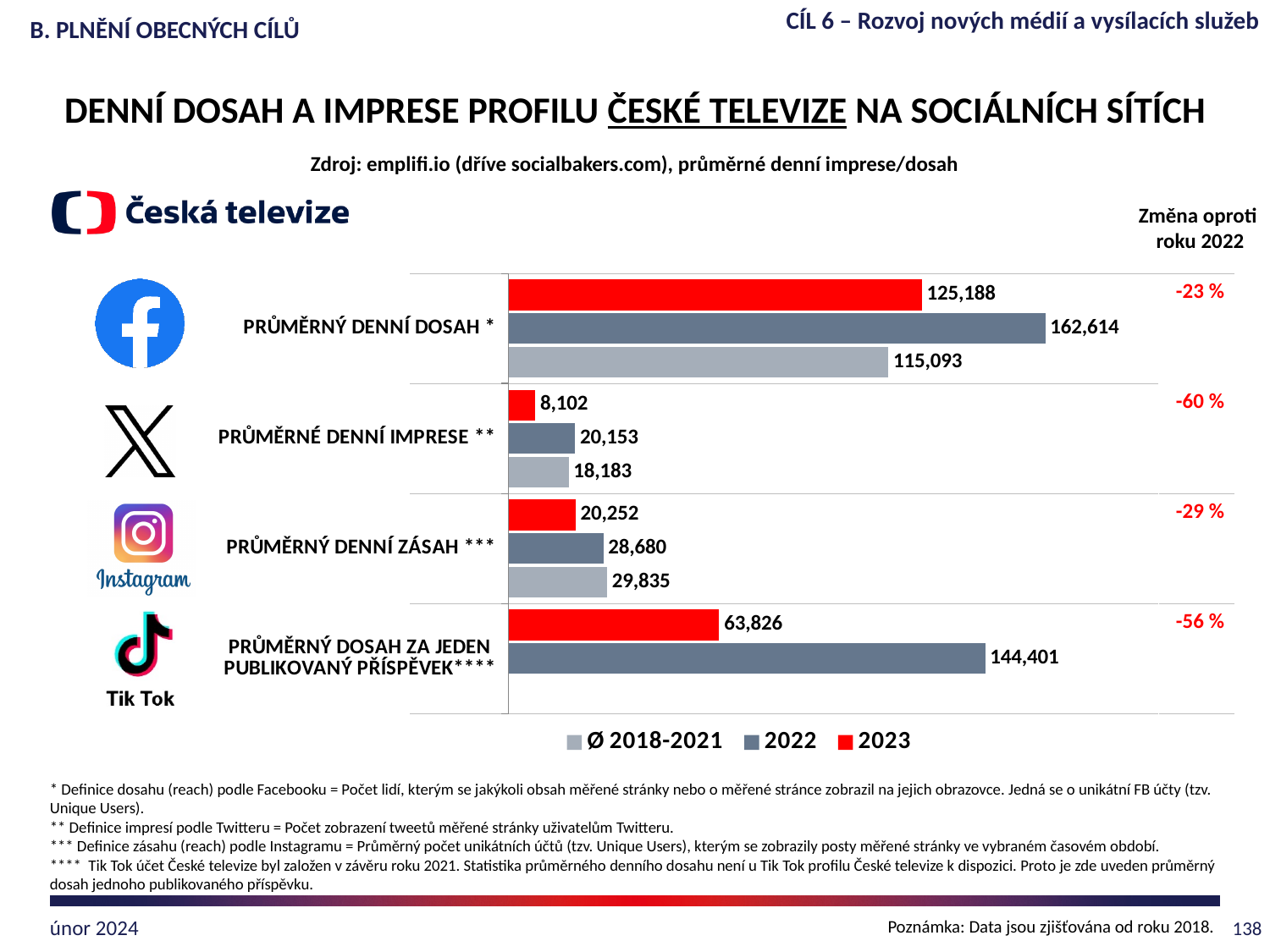
Which category has the highest 2023 value? PRŮMĚRNÝ DENNÍ DOSAH What is the Ø 2018-2021 value for PRŮMĚRNÝ DENNÍ ZÁSAH (Instagram)? 29,835 What is the change versus 2022 shown for PRŮMĚRNÉ DENNÍ IMPRESE (X)? -60 % What is the 2022 value for PRŮMĚRNÝ DOSAH ZA JEDEN PUBLIKOVANÝ PŘÍSPĚVEK (Tik Tok)? 144,401 What kind of chart is shown on the slide? Bar chart How many series does the legend list? 3 What is the 2023 value for PRŮMĚRNÝ DENNÍ DOSAH (Facebook)? 125,188 What is the 2022 value for PRŮMĚRNÉ DENNÍ IMPRESE (X)? 20,153 How many categories are shown on the chart? 4 For PRŮMĚRNÝ DENNÍ ZÁSAH (Instagram), which is larger: the 2022 value or the Ø 2018-2021 value? Ø 2018-2021 What is the difference between the 2022 and 2023 values for PRŮMĚRNÝ DENNÍ DOSAH (Facebook)? 37,426 Which category has the lowest 2023 value? PRŮMĚRNÉ DENNÍ IMPRESE